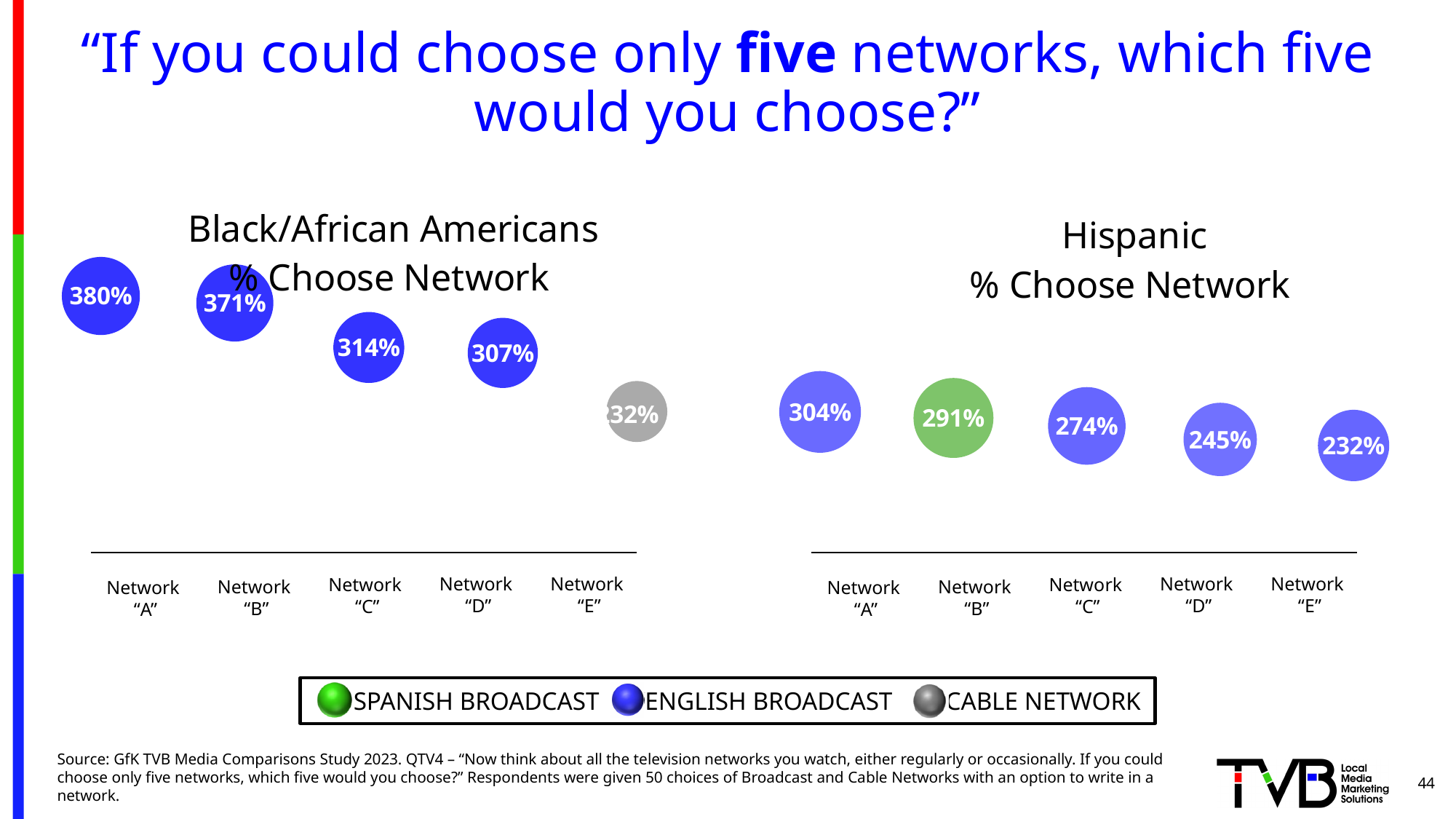
In the Black/African Americans % Choose Network chart, what is the difference between Network "A" and Network "D"? 73% In the Hispanic % Choose Network chart, which network has the lowest value? Network "E" In the Black/African Americans % Choose Network chart, what is the value for Network "C"? 314% In the Hispanic % Choose Network chart, what is the value for Network "E"? 232% In the Hispanic % Choose Network chart, which network has the highest value? Network "A" In the Black/African Americans % Choose Network chart, which network has the highest value? Network "A" In the Hispanic % Choose Network chart, what is the difference between Network "A" and Network "C"? 30% How many networks are shown in the Hispanic % Choose Network chart? 5 In the Hispanic % Choose Network chart, what is the value for Network "B"? 291% How many entries does the legend at the bottom of the slide list? 3 Which is larger: Network "B" in the Black/African Americans chart or Network "B" in the Hispanic chart? Network "B" in the Black/African Americans chart In the Black/African Americans % Choose Network chart, what is the value for Network "A"? 380%